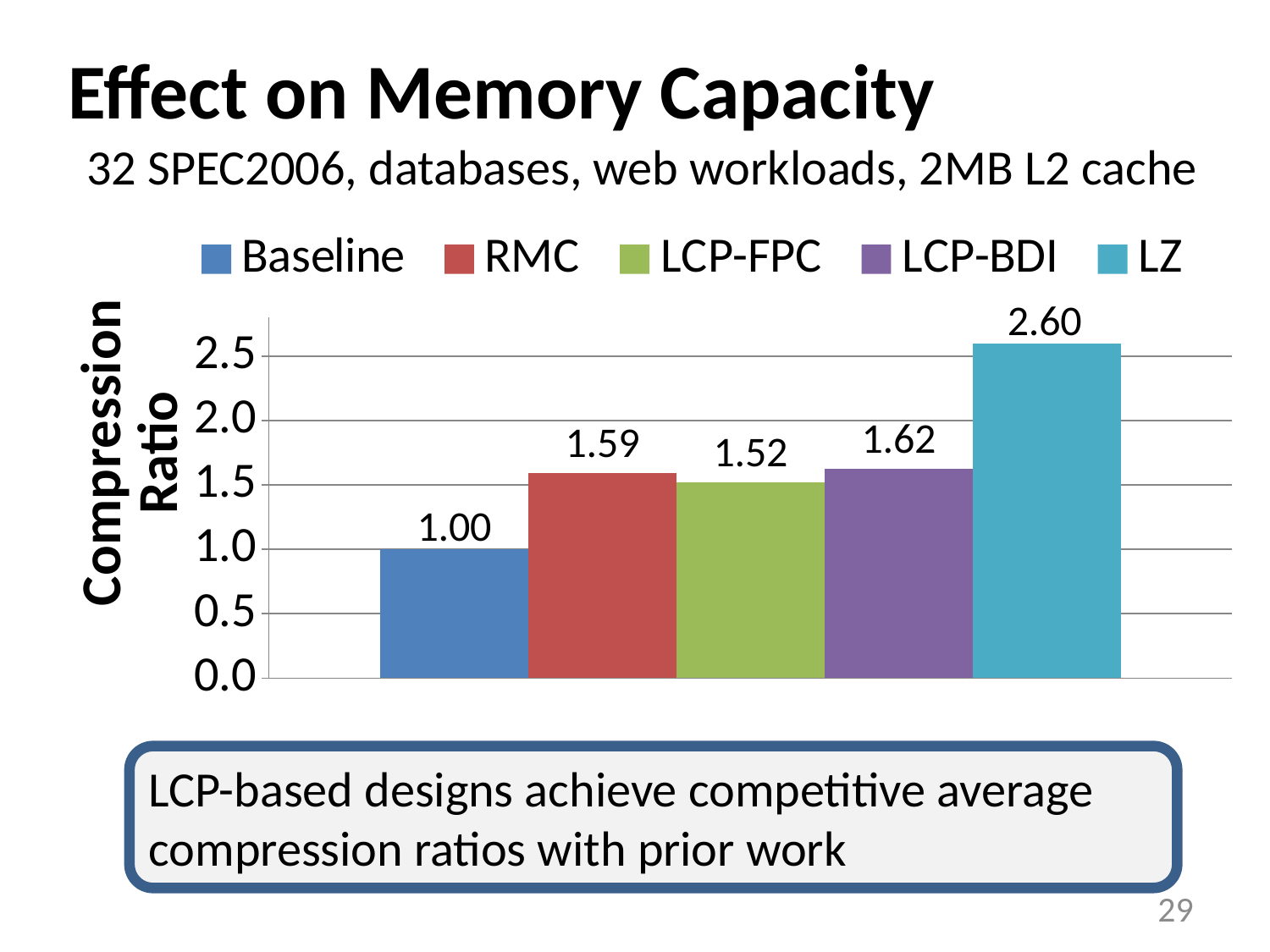
Which has a larger compression ratio, RMC or LCP-FPC? RMC How many series does the legend list? 5 What is the label of the vertical axis? Compression Ratio What is the difference between the compression ratios of LCP-BDI and LCP-FPC? 0.10 What is the compression ratio for LCP-BDI? 1.62 Is the compression ratio for LZ greater or less than 2.5? greater What is the compression ratio for RMC? 1.59 What is the compression ratio for LCP-FPC? 1.52 Which series has the highest compression ratio? LZ What kind of chart is shown on the slide? bar chart Which series has the lowest compression ratio? Baseline What is the difference between the compression ratios of LZ and Baseline? 1.60